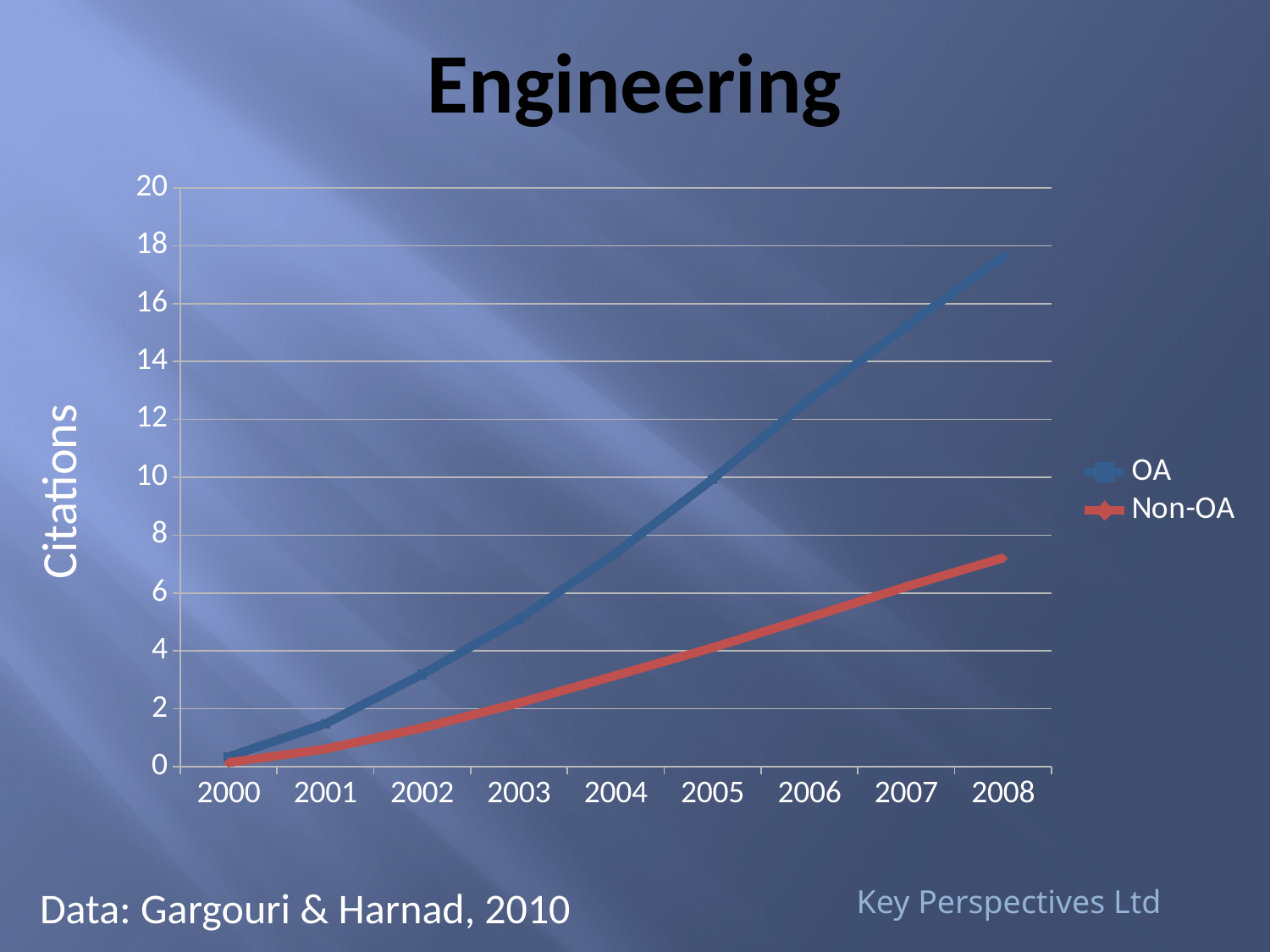
What kind of chart is shown on the slide? line chart Is the OA value for 2008 greater or less than 16? greater Which series has the higher value in 2008, OA or Non-OA? OA Is the Non-OA value for 2008 greater or less than 8? less Is the OA value for 2006 greater or less than 12? greater What is the title of the chart? Engineering How many series does the legend list? 2 In which year does the OA series reach its highest value? 2008 Do the OA citations rise or fall from 2000 to 2008? rise How many years are shown along the x axis? 9 What are the two series named in the legend? OA and Non-OA